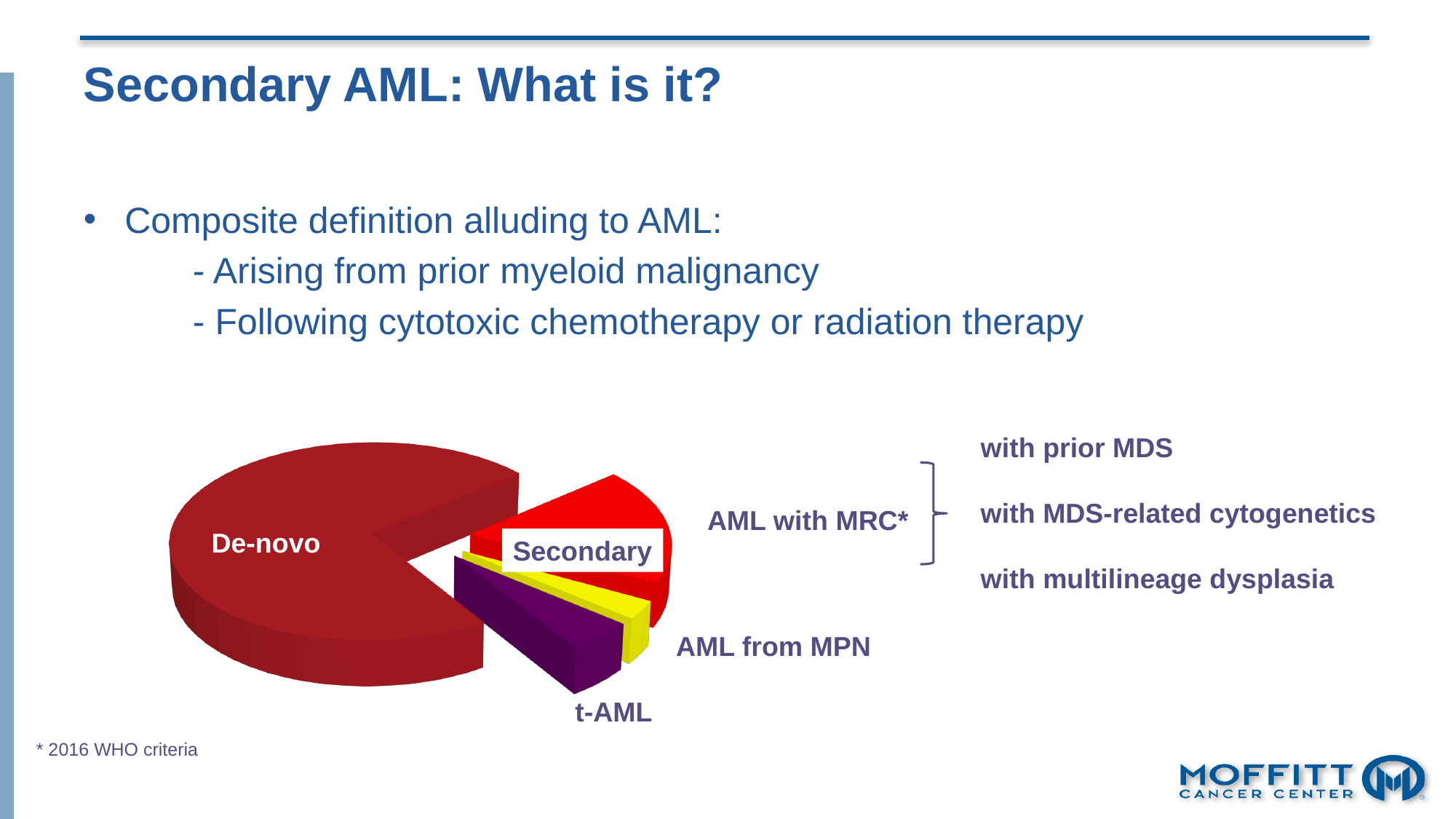
What kind of chart is shown on the slide? pie chart Which slice is larger, t-AML or AML from MPN? t-AML Which slice is larger, AML with MRC* or AML from MPN? AML with MRC* Which slice of the pie chart is the smallest? AML from MPN Which slice is larger, De-novo or t-AML? De-novo What colour is the De-novo slice of the pie chart? dark red How many slices does the pie chart have? 4 Which slice of the pie chart is the largest? De-novo Which slices of the pie chart are grouped together under the label 'Secondary'? AML with MRC*, AML from MPN and t-AML